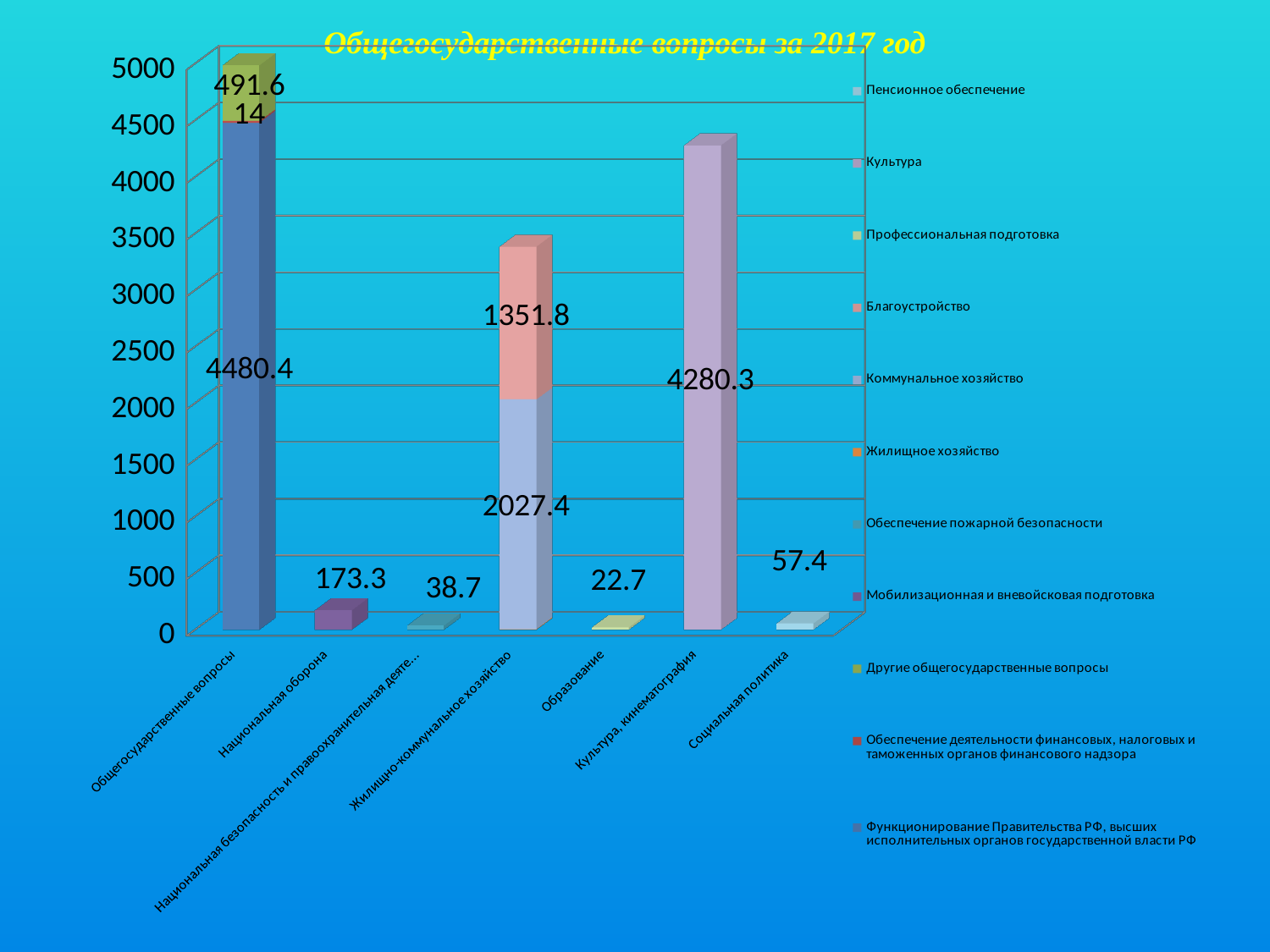
What is the value shown for Культура, кинематография? 4280.3 Which is larger: the value for Социальная политика or the value for Образование? Социальная политика What is the value of the bottom segment of the bar for Общегосударственные вопросы? 4480.4 What type of chart is shown on the slide? Bar chart What is the value shown for Национальная оборона? 173.3 What is the difference between the values for Национальная оборона and Социальная политика? 115.9 How many categories are shown on the x axis? 7 What is the value of the top segment of the bar for Жилищно-коммунальное хозяйство? 1351.8 Which category has the tallest bar on the chart? Общегосударственные вопросы Which category has the lowest value on the chart? Образование How many entries does the legend list? 11